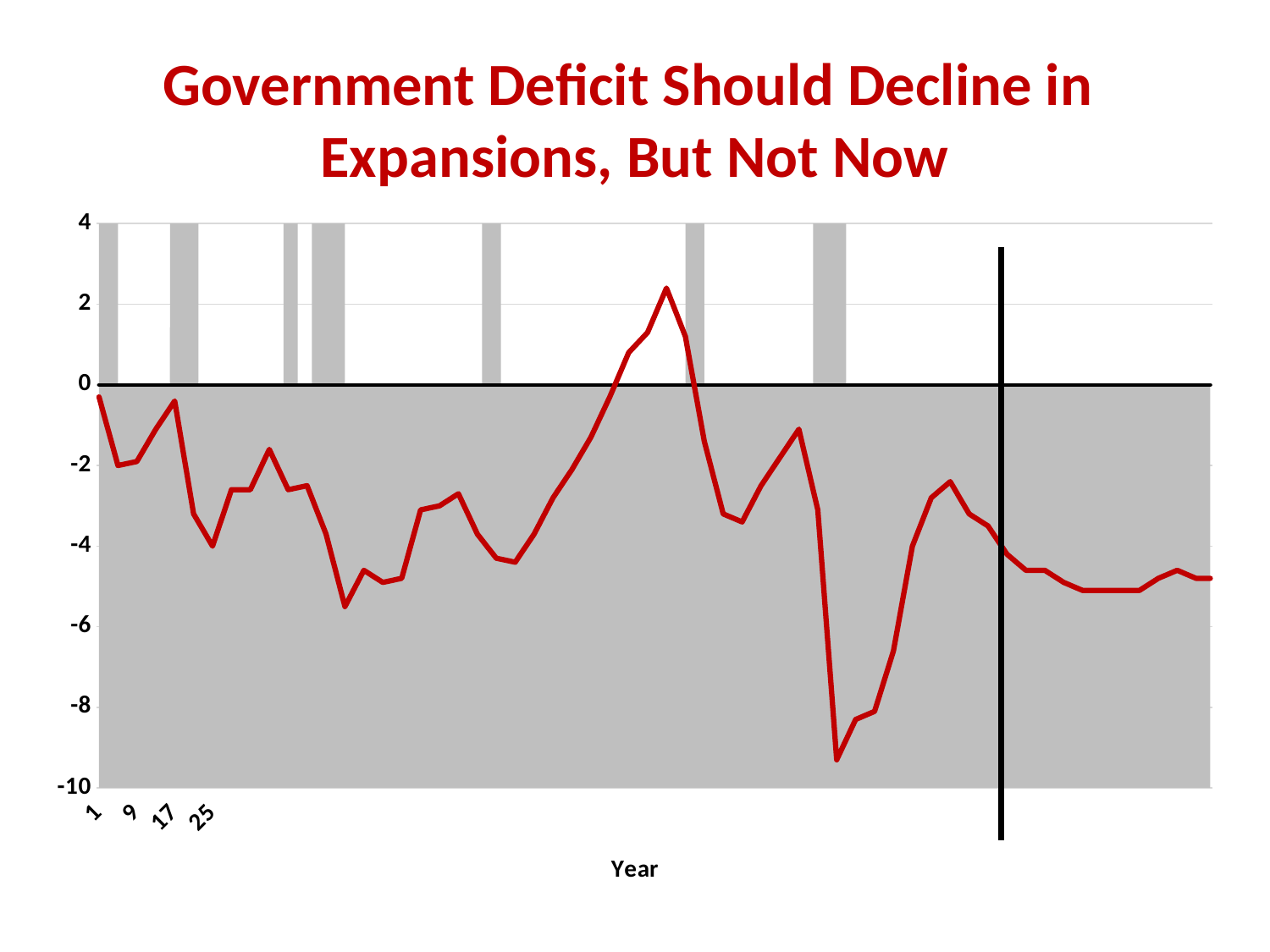
Which is larger, the value of the line at year 1 or the value at year 25? year 1 What kind of chart is shown on the slide? line chart What is the label on the x axis of the chart? Year What is the title of the chart on the slide? Government Deficit Should Decline in Expansions, But Not Now Is the lowest point of the line greater or less than -8? less Is the value of the line at year 1 greater or less than -2? greater Is the highest point of the line greater or less than 0? greater What is the lowest value shown on the y axis of the chart? -10 Comparing the start of the line at year 1 with its end at the far right, does the line overall rise or fall across the chart? fall